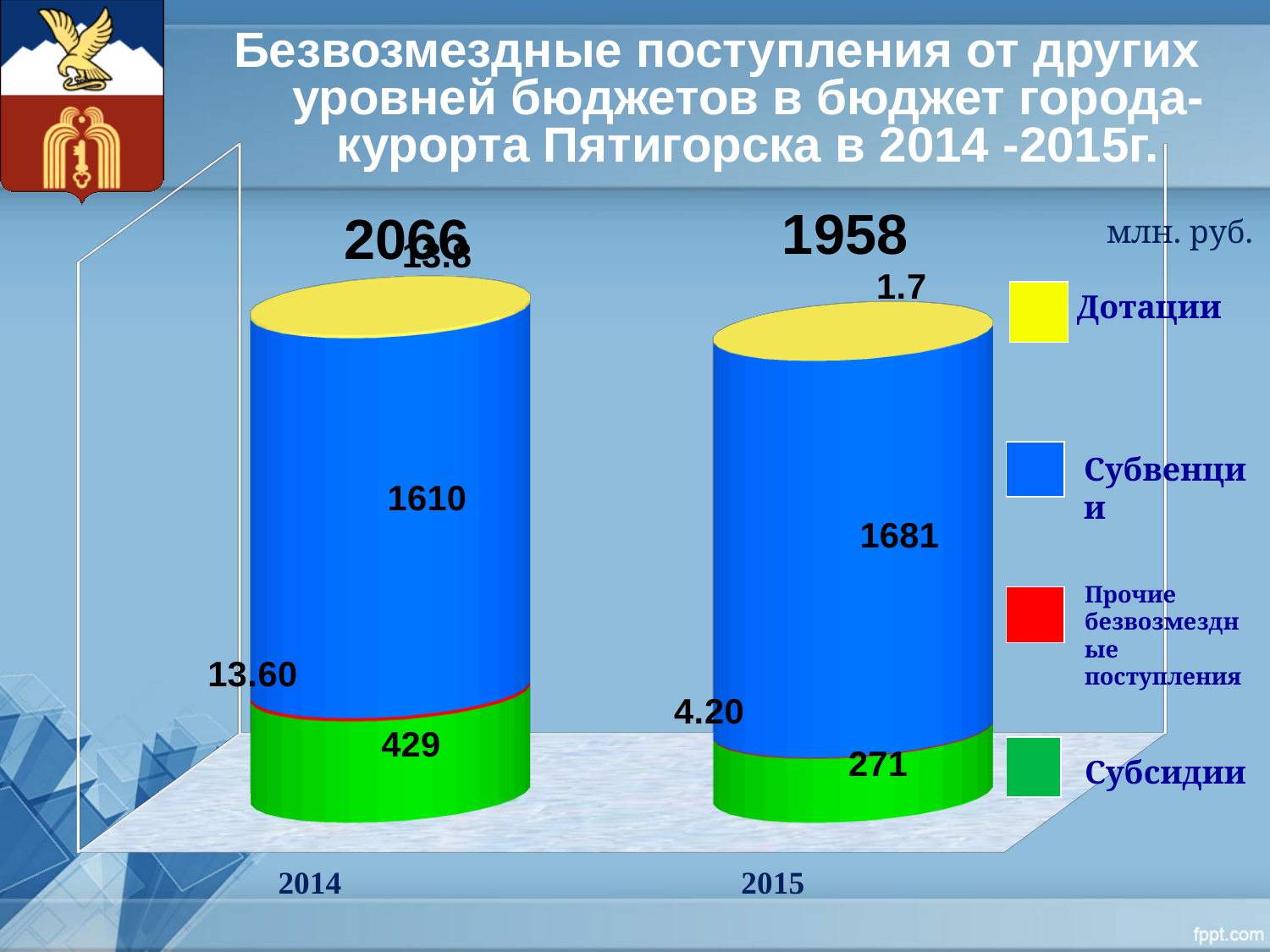
How many years (categories) are plotted on the chart? 2 How many series does the legend list? 4 What is the total of the stacked bar for 2014? 2066 By how much did Субвенции increase from 2014 to 2015? 71 What is the value of Дотации for 2015? 1.7 What is the value of Субвенции for 2014? 1610 What is the value of Прочие безвозмездные поступления for 2015? 4.20 What kind of chart is shown on the slide? bar chart What is the value of Субвенции for 2015? 1681 In what units are the values on the chart given? млн. руб. Which year has the larger value for Субсидии, 2014 or 2015? 2014 What is the value of Субсидии for 2014? 429